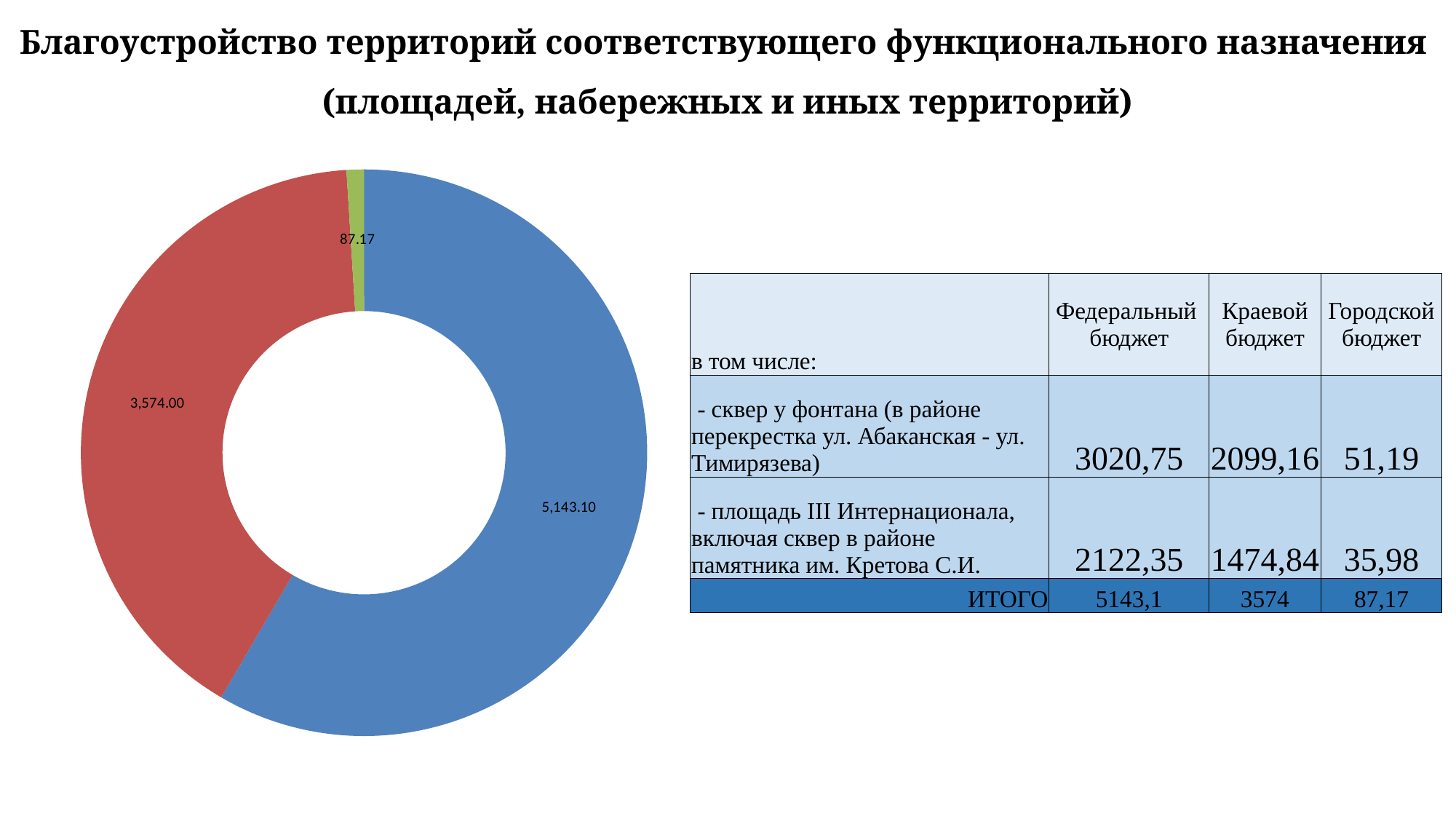
According to the table on the slide, which budget does the blue slice value 5,143.10 correspond to? Федеральный бюджет What value is labelled on the red slice of the doughnut chart? 3,574.00 What is the difference between the blue slice (5,143.10) and the red slice (3,574.00) in the doughnut chart? 1,569.10 Which slice of the doughnut chart is the largest, and what is its value? the blue slice, 5,143.10 Which slice of the doughnut chart is the smallest, and what is its value? the green slice, 87.17 How many slices does the doughnut chart have? 3 What value is labelled on the green slice of the doughnut chart? 87.17 Which is larger in the doughnut chart: the red slice or the green slice? the red slice What kind of chart is shown on the slide? doughnut (pie) chart According to the table on the slide, which budget does the green slice value 87.17 correspond to? Городской бюджет What is the sum of the three values shown on the doughnut chart? 8,804.27 What value is labelled on the blue slice of the doughnut chart? 5,143.10